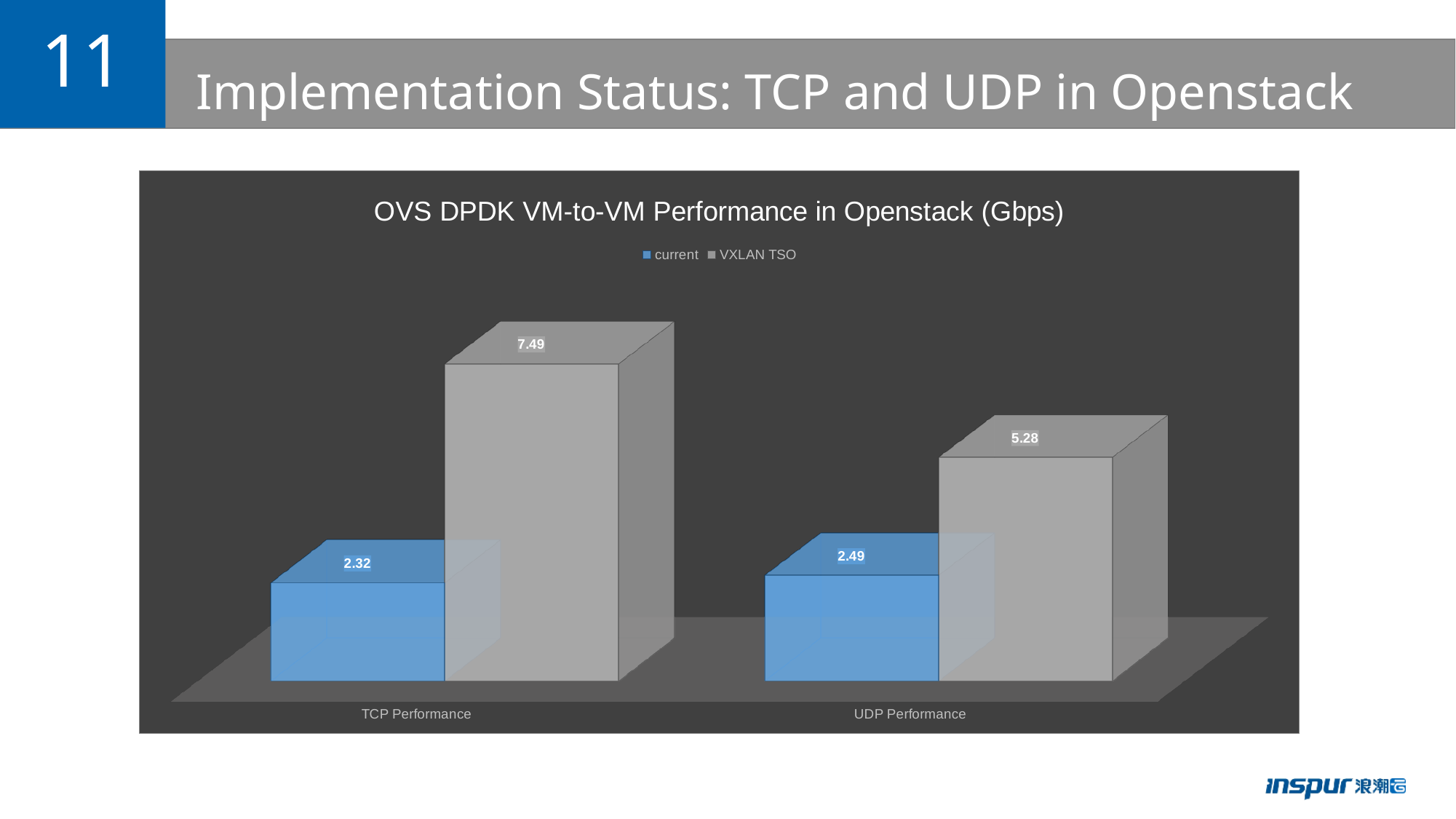
What is the VXLAN TSO value for UDP Performance? 5.28 What is the current value for TCP Performance? 2.32 What is the VXLAN TSO value for TCP Performance? 7.49 Which category has the highest VXLAN TSO value? TCP Performance How many series does the legend list? 2 What is the current value for UDP Performance? 2.49 Which category has the lowest current value? TCP Performance Which is larger for UDP Performance, the current value or the VXLAN TSO value? VXLAN TSO What is the difference between the VXLAN TSO and current values for TCP Performance? 5.17 What is the difference between the VXLAN TSO and current values for UDP Performance? 2.79 How many categories are shown on the x axis? 2 What kind of chart is shown on the slide? Bar chart